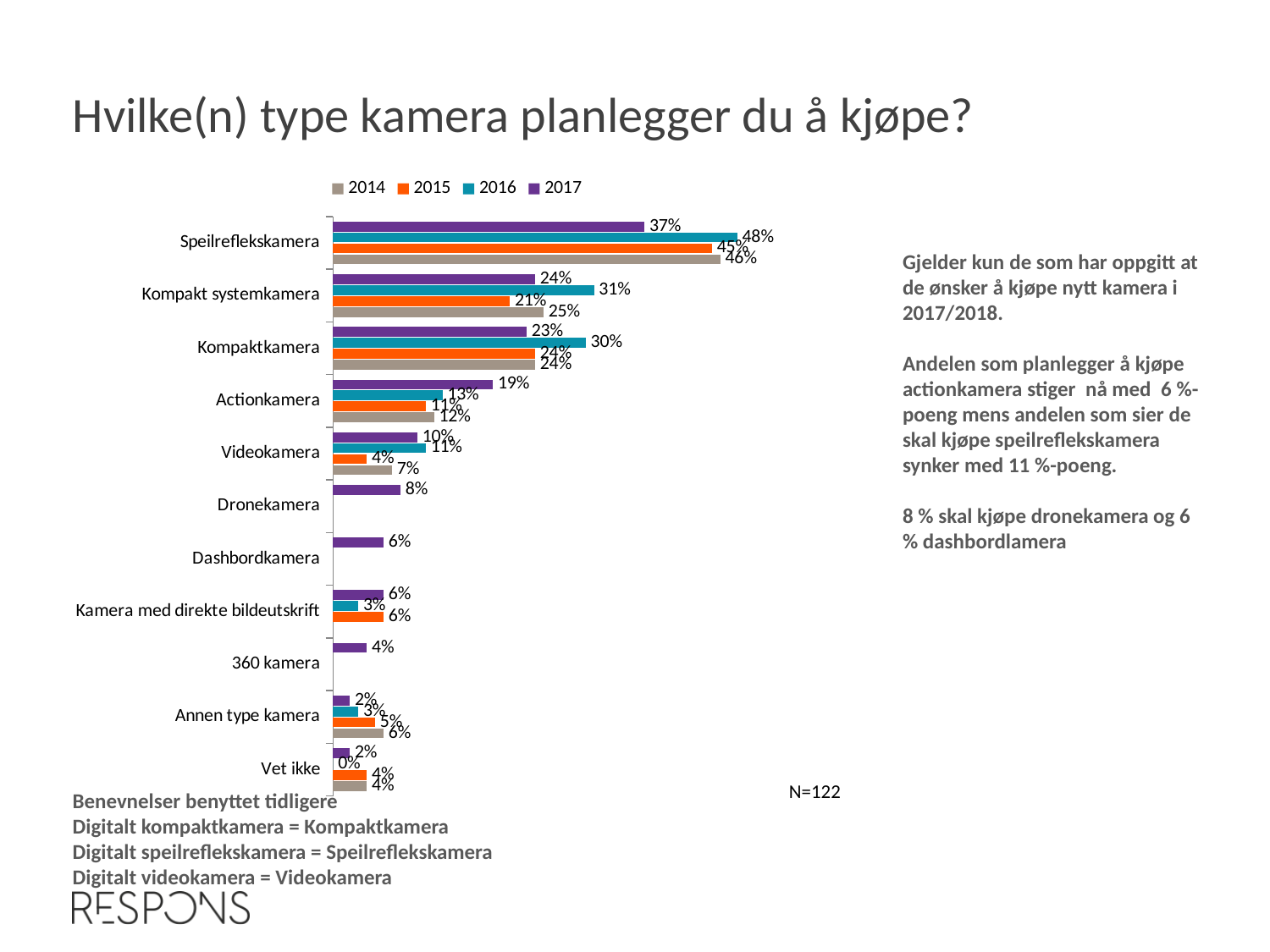
What is the 2017 value for Speilreflekskamera? 37% What share plans to buy a Dronekamera in 2017? 8% What is the difference between the 2017 and 2016 values for Actionkamera? 6% For Kompaktkamera, which year has the larger value, 2015 or 2016? 2016 Which category has the highest 2017 value? Speilreflekskamera What is the 2016 value for Kompakt systemkamera? 31% What is the 2016 value for Vet ikke? 0% How many series does the legend list? 4 What kind of chart is shown on the slide? Bar chart What is the 2017 value for 360 kamera? 4% What is the difference between the 2016 and 2017 values for Speilreflekskamera? 11% How many categories are shown on the chart? 11